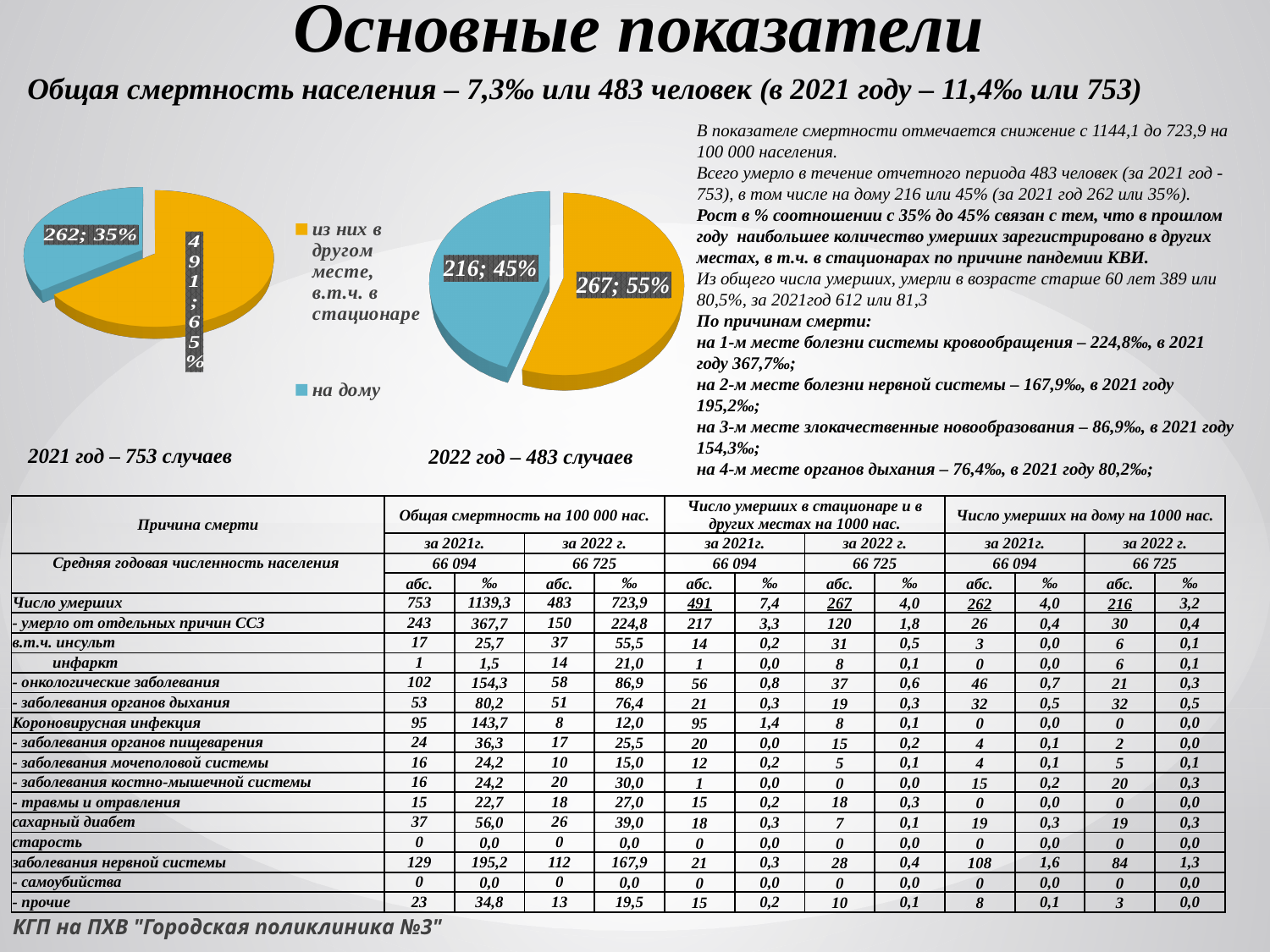
Which colour represents 'на дому' in the pie charts' legend? blue In the 2022 год – 483 случаев pie chart, what value is shown for the 'на дому' slice? 216; 45% In the 2022 год – 483 случаев pie chart, what share of the pie does the 'на дому' slice represent? 45% In the 2022 год – 483 случаев pie chart, what value is shown for the 'из них в другом месте, в.т.ч. в стационаре' slice? 267; 55% In the 2021 год – 753 случаев pie chart, what value is shown for the 'из них в другом месте, в.т.ч. в стационаре' slice? 491; 65% In the 2022 год – 483 случаев pie chart, which slice is the smallest? на дому In the 2022 год – 483 случаев pie chart, what is the difference between the 'из них в другом месте, в.т.ч. в стационаре' count and the 'на дому' count? 51 What kind of chart is used for the 2021 год – 753 случаев chart? pie chart In the 2021 год – 753 случаев pie chart, what value is shown for the 'на дому' slice? 262; 35% In the 2021 год – 753 случаев pie chart, what share of the pie does the 'из них в другом месте, в.т.ч. в стационаре' slice represent? 65% How many slices does the 2021 год – 753 случаев pie chart have? 2 In the 2021 год – 753 случаев pie chart, which slice is the largest? из них в другом месте, в.т.ч. в стационаре